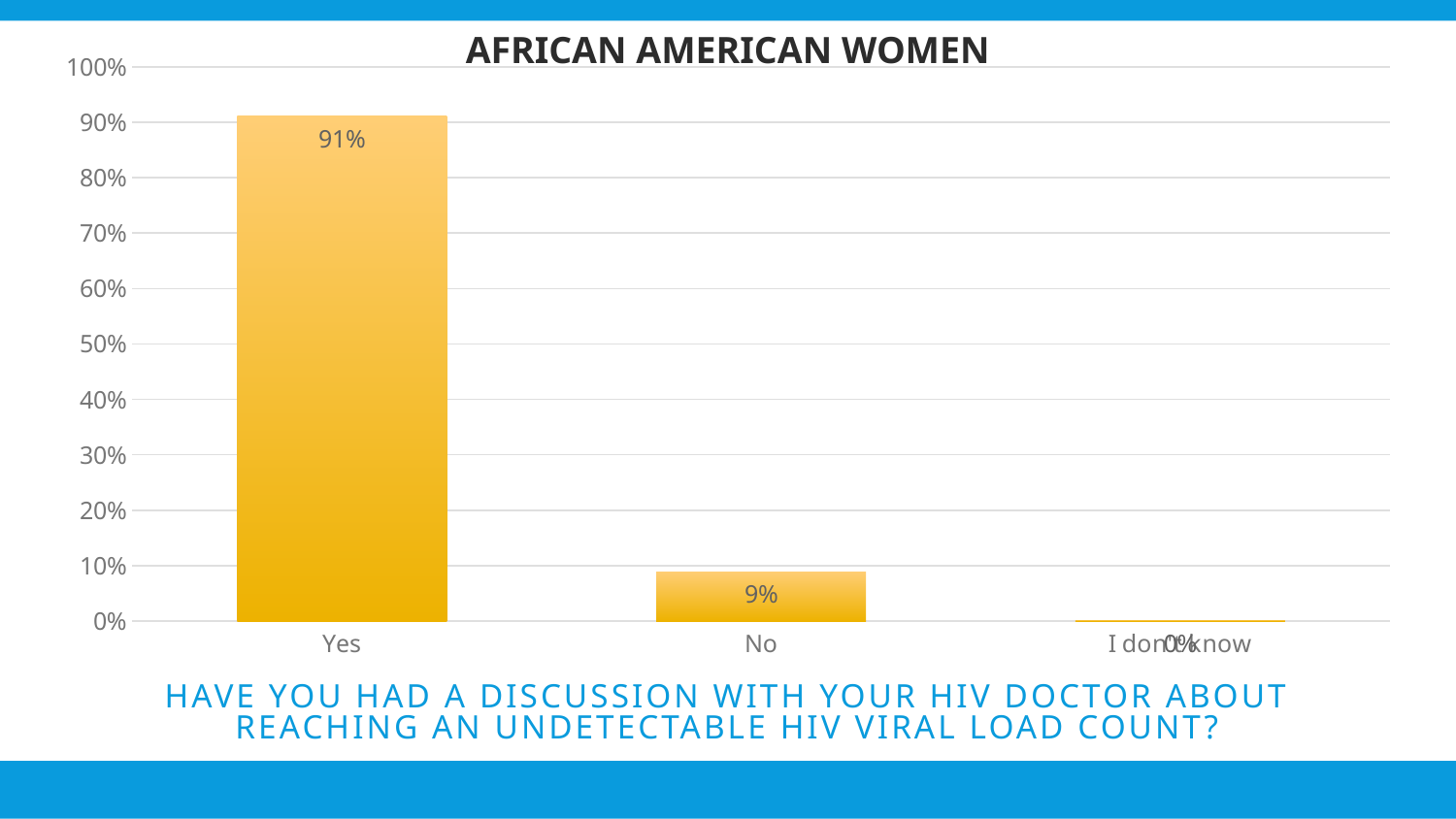
What is the value for Yes? 91% What kind of chart is shown on the slide? bar chart Is the value for No greater or less than 20%? less What is the title of the chart? AFRICAN AMERICAN WOMEN What is the difference between the values for Yes and No? 82% Which category has the lowest value? I don't know Which category has the highest value? Yes Is the value for Yes greater or less than 80%? greater How many categories are shown on the x axis? 3 Which is larger, the value for Yes or the value for No? Yes What is the value for No? 9% What is the value for I don't know? 0%